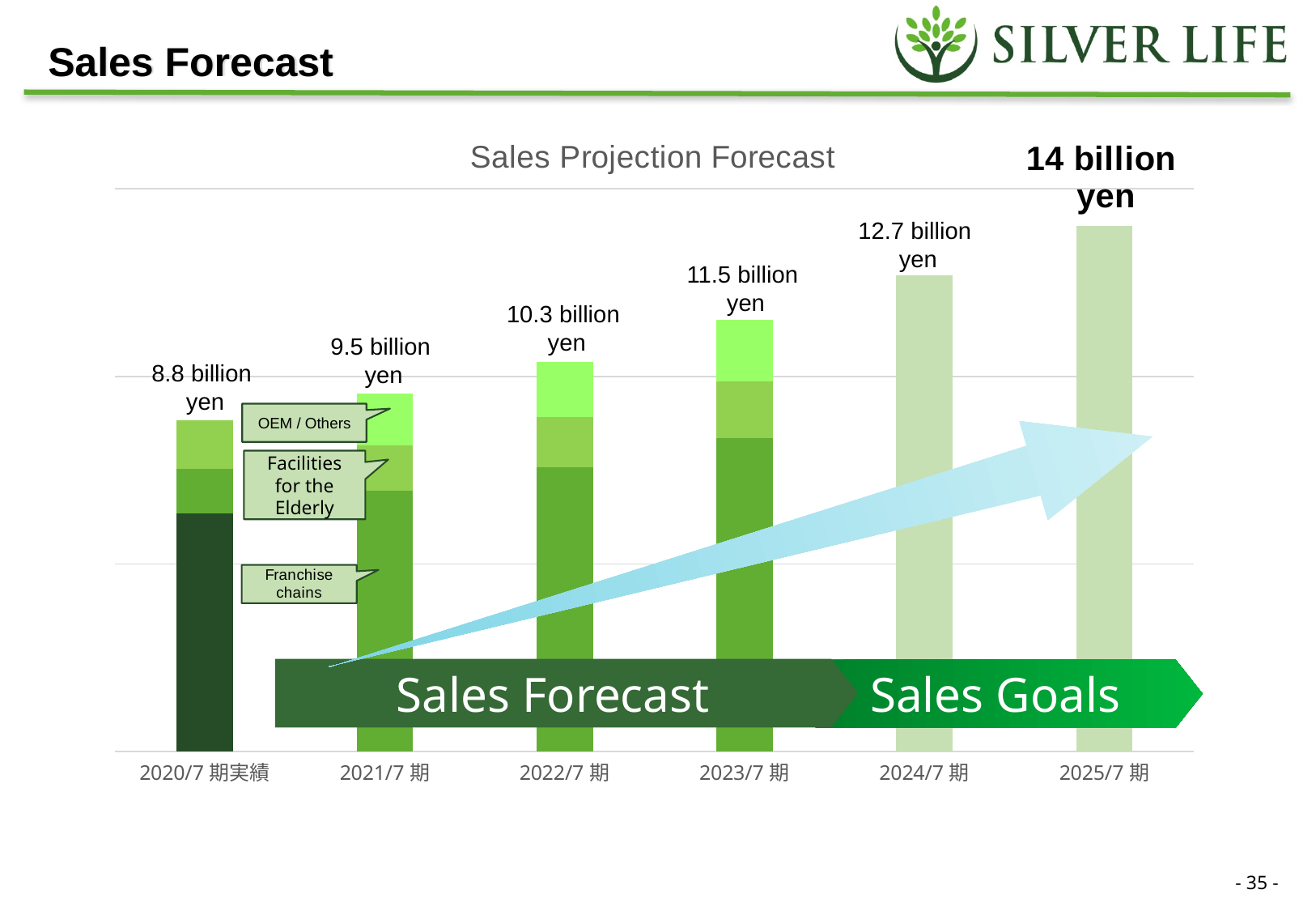
Which period has the lowest sales value on the chart? 2020/7 期実績 What is the sales value shown for 2020/7 期実績? 8.8 billion yen What is the difference between the sales values for 2024/7 期 and 2023/7 期? 1.2 billion yen What is the total sales value shown for 2022/7 期? 10.3 billion yen What is the difference between the sales value for 2025/7 期 and 2020/7 期実績? 5.2 billion yen Which is larger, the sales value for 2021/7 期 or for 2023/7 期? 2023/7 期 How many periods are shown on the x axis of the chart? 6 What is the sales value shown for 2024/7 期? 12.7 billion yen What is the sales goal shown for 2025/7 期? 14 billion yen Which period has the highest sales value on the chart? 2025/7 期 What kind of chart is shown on the slide? Stacked bar chart Do the sales values rise or fall from 2020/7 期実績 to 2025/7 期? Rise